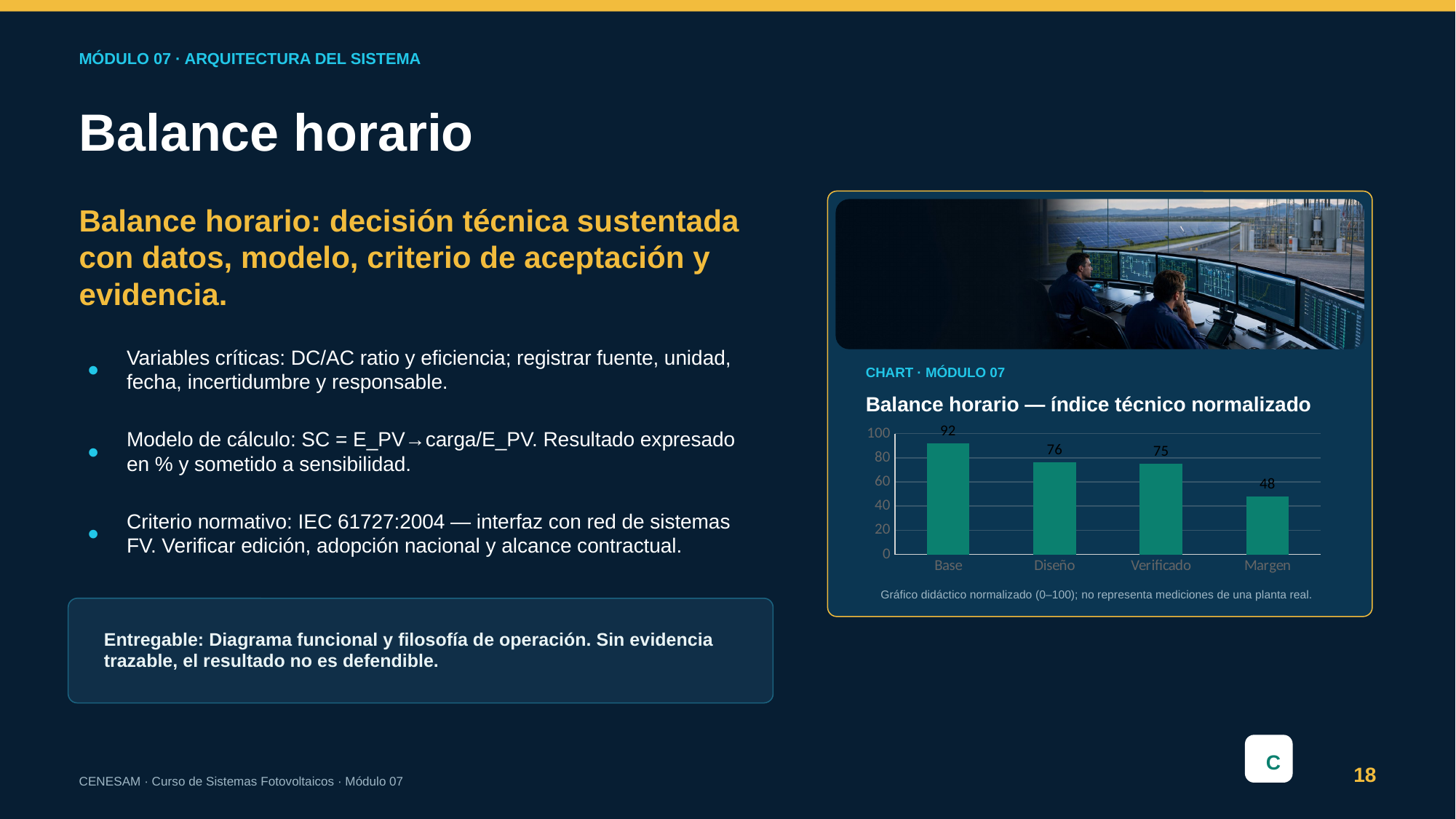
What kind of chart is shown? bar chart How many categories are shown on the x axis? 4 What is the value for Margen? 48 What is the value for Diseño? 76 Which is larger, the value for Base or the value for Verificado? Base What is the title of the chart? Balance horario — índice técnico normalizado Which category has the highest value? Base Which category has the lowest value? Margen Is the value for Margen greater or less than 60? less What is the difference between the values for Diseño and Verificado? 1 What is the difference between the values for Base and Margen? 44 What is the value for Base? 92